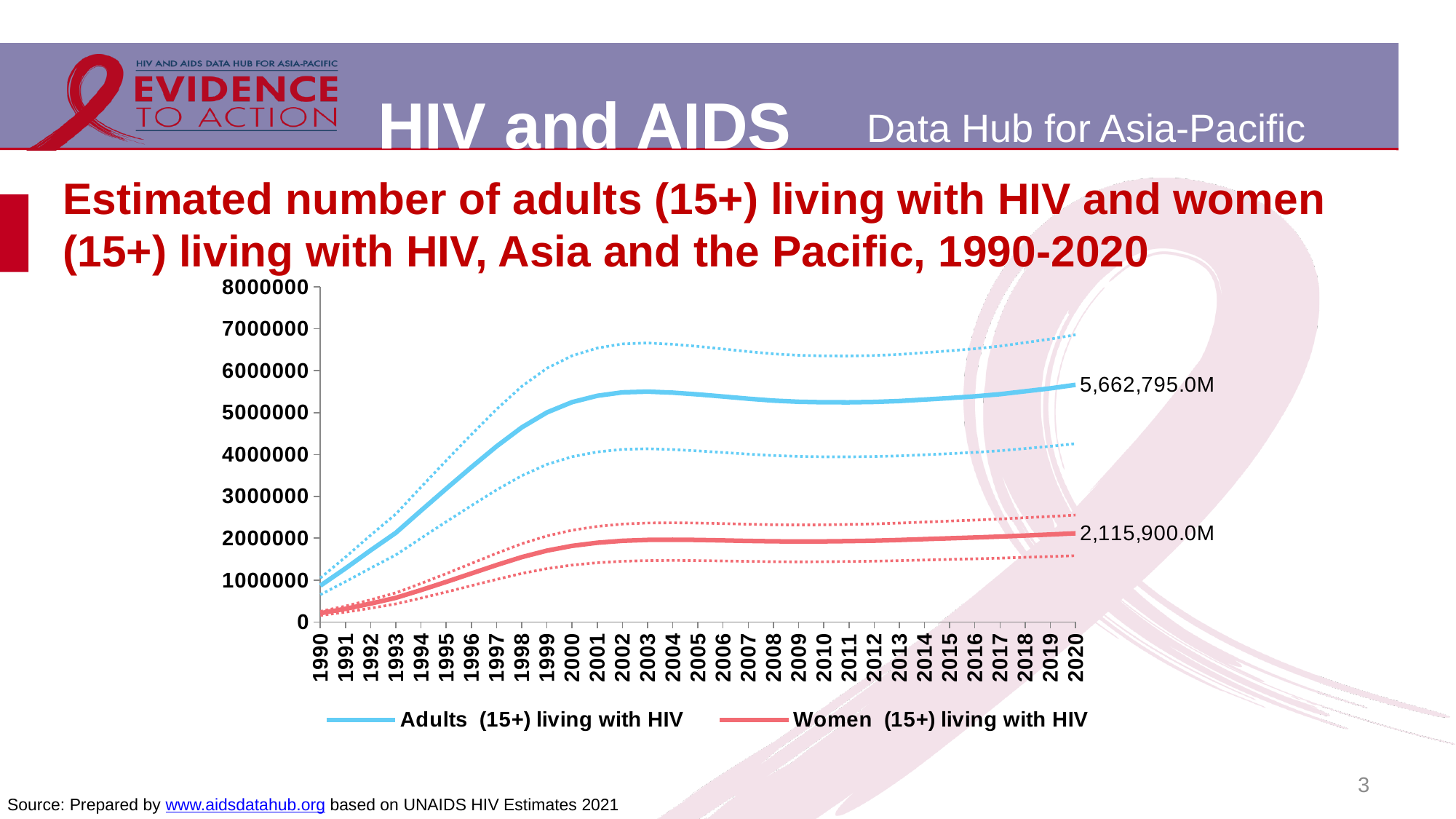
What colour is the line for Women (15+) living with HIV? Red How many years are shown along the x axis? 31 Is the value for Adults (15+) living with HIV in 2003 greater or less than 5000000? greater Is the value for Women (15+) living with HIV in 1990 greater or less than 1000000? less Which series has the higher values across the whole period? Adults (15+) living with HIV What is the value for Adults (15+) living with HIV in 2020? 5,662,795.0M Does the Adults (15+) living with HIV line rise or fall between 1990 and 2000? rise What is the value for Women (15+) living with HIV in 2020? 2,115,900.0M What is the difference between the 2020 values for Adults (15+) living with HIV and Women (15+) living with HIV? 3,546,895.0M What kind of chart is shown on the slide? Line chart How many series does the legend list? 2 In 2020, which is larger: Adults (15+) living with HIV or Women (15+) living with HIV? Adults (15+) living with HIV